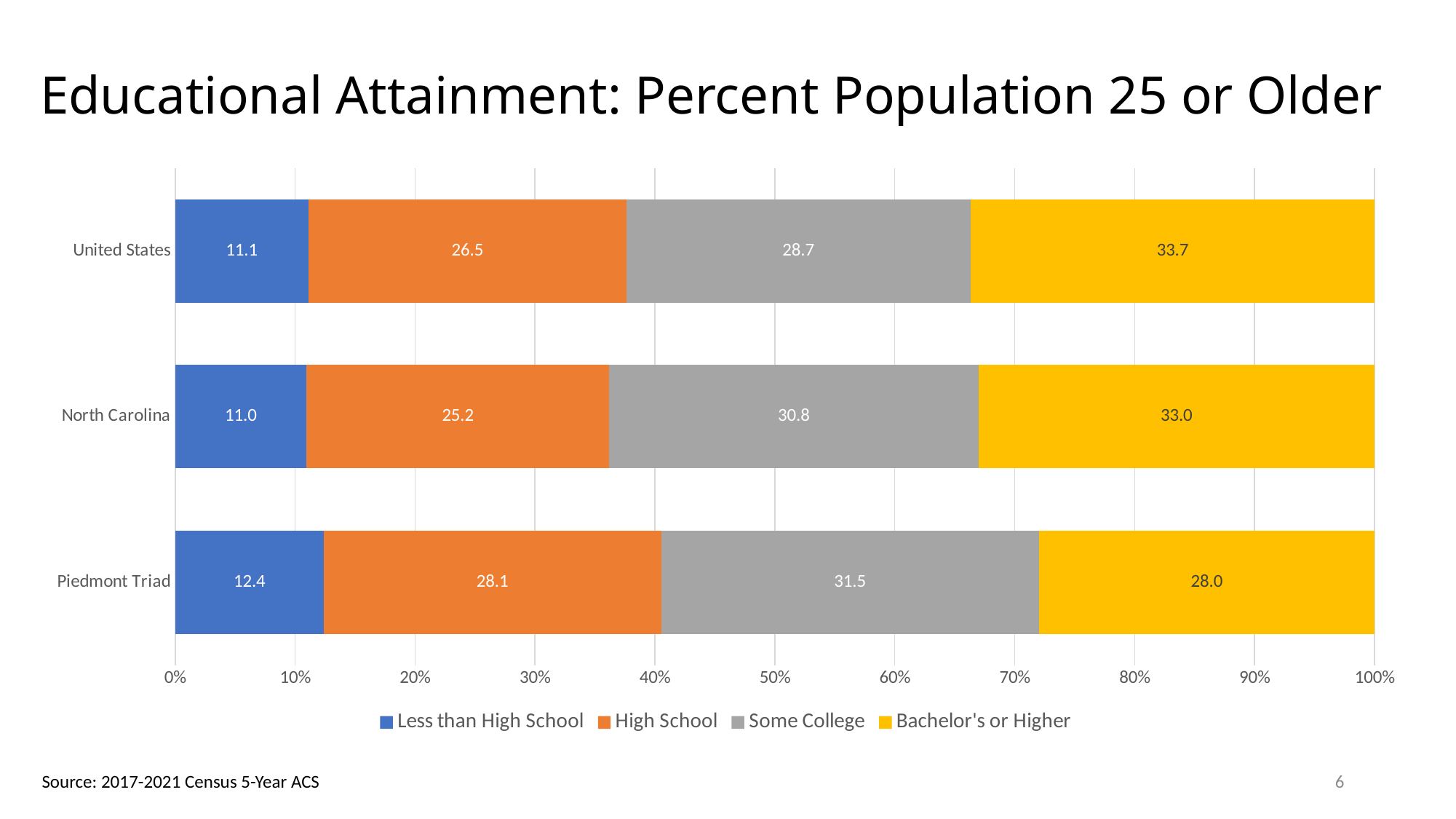
Which region has the highest value for Bachelor's or Higher? United States Which is larger: the Some College value for North Carolina or for the United States? North Carolina What is the value for Some College in the Piedmont Triad? 31.5 What is the value for Bachelor's or Higher in the United States? 33.7 How many series does the legend list? 4 What is the total of the stacked bar for the Piedmont Triad? 100.0 Which region has the lowest value for Less than High School? North Carolina What is the title of the chart? Educational Attainment: Percent Population 25 or Older What kind of chart is shown on the slide? Stacked bar chart What is the value for High School in North Carolina? 25.2 How many regions are shown on the chart? 3 What is the difference between the Bachelor's or Higher values for North Carolina and the Piedmont Triad? 5.0